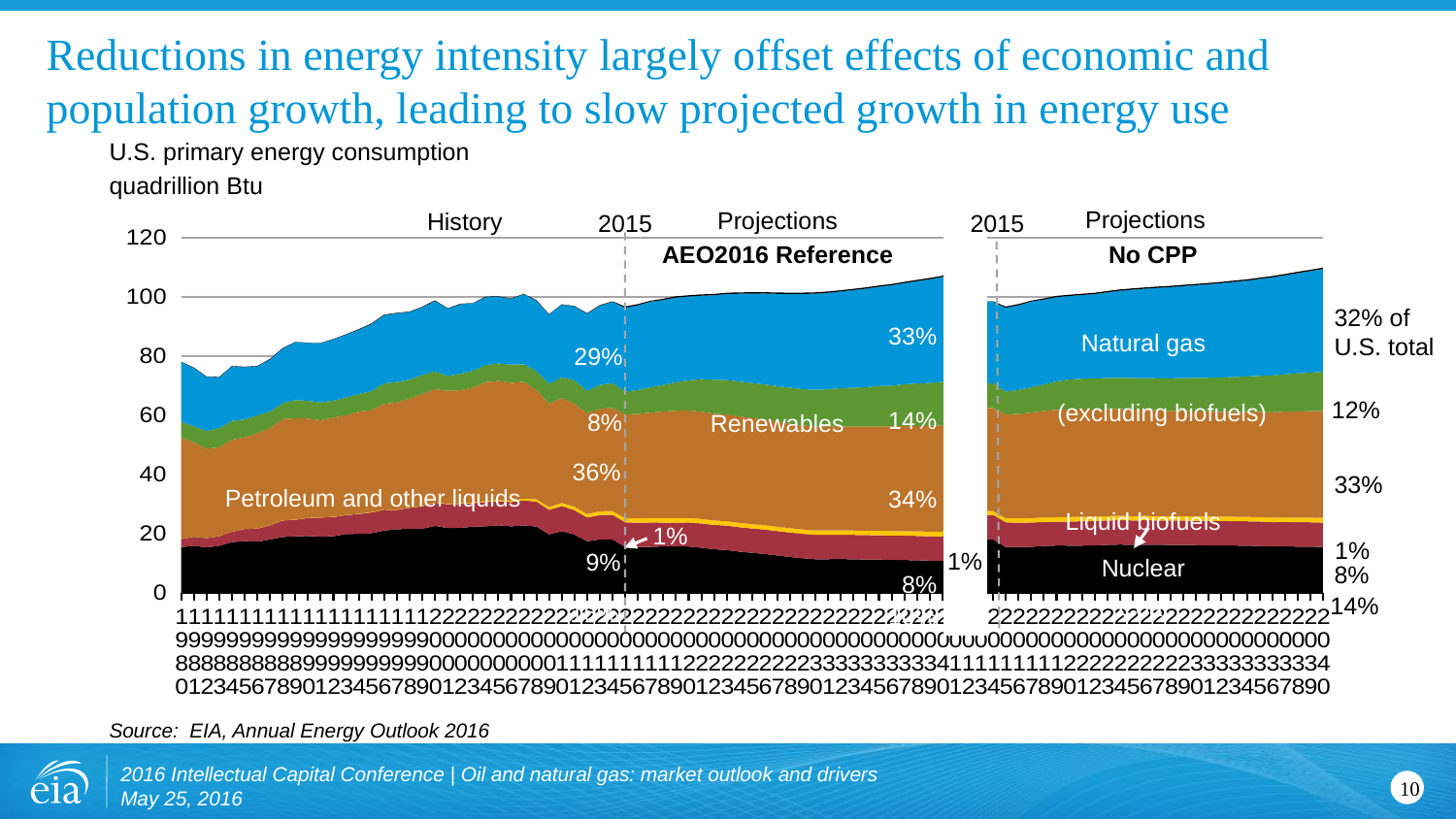
In the AEO2016 Reference chart, what share of U.S. primary energy consumption does natural gas hold in 2015? 29% In the AEO2016 Reference chart, what share do renewables (excluding biofuels) hold at the end of the projection period? 14% In the AEO2016 Reference chart, does total U.S. primary energy consumption rise or fall over the projection period? Rise What kind of chart is used on this slide to show U.S. primary energy consumption? Stacked area chart What unit is used on the y axis of the charts? quadrillion Btu In the No CPP chart, what share of the U.S. total does natural gas hold at the end of the projection period? 32% Which chart shows a larger end-of-projection share for natural gas, AEO2016 Reference or No CPP? AEO2016 Reference In the No CPP chart, what share do renewables (excluding biofuels) hold at the end of the projection period? 12% In the AEO2016 Reference chart, what share does petroleum and other liquids hold in 2015? 36% In the AEO2016 Reference chart, what share does natural gas hold at the end of the projection period? 33% What is the difference between the end-of-projection renewables share in the AEO2016 Reference chart (14%) and in the No CPP chart (12%)? 2 percentage points In the AEO2016 Reference chart, is total primary energy consumption at the end of the projection period greater or less than 100 quadrillion Btu? greater